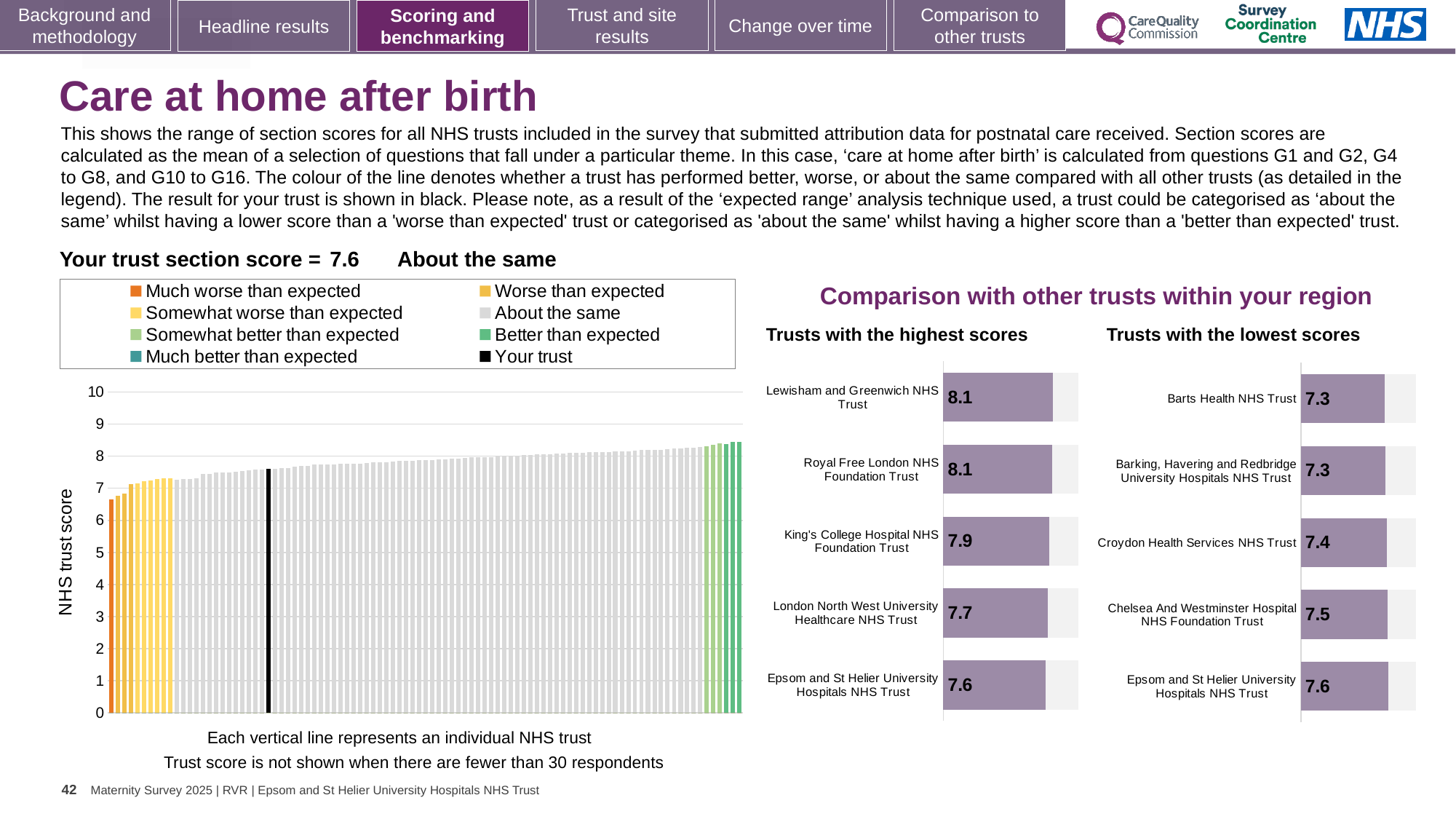
In the 'Trusts with the lowest scores' chart, which has the larger score: Chelsea And Westminster Hospital NHS Foundation Trust or Croydon Health Services NHS Trust? Chelsea And Westminster Hospital NHS Foundation Trust In the 'Trusts with the highest scores' chart, what is the score for King's College Hospital NHS Foundation Trust? 7.9 In the 'NHS trust score' chart, is the value for the black 'Your trust' bar greater or less than 5? greater In the 'Trusts with the highest scores' chart, which trust has the lowest score? Epsom and St Helier University Hospitals NHS Trust In the 'Trusts with the highest scores' chart, what is the difference between the scores of Lewisham and Greenwich NHS Trust and Epsom and St Helier University Hospitals NHS Trust? 0.5 In the 'Trusts with the lowest scores' chart, what is the difference between the scores of Chelsea And Westminster Hospital NHS Foundation Trust and Barts Health NHS Trust? 0.2 How many entries does the legend of the 'NHS trust score' chart list? 8 What kind of chart is the 'NHS trust score' chart on the left? Bar chart In the 'Trusts with the lowest scores' chart, what is the score for Croydon Health Services NHS Trust? 7.4 How many trusts are shown in the 'Trusts with the highest scores' chart? 5 In the 'Trusts with the lowest scores' chart, which trust has the highest score? Epsom and St Helier University Hospitals NHS Trust In the 'NHS trust score' chart, do the bars rise or fall from left to right? Rise